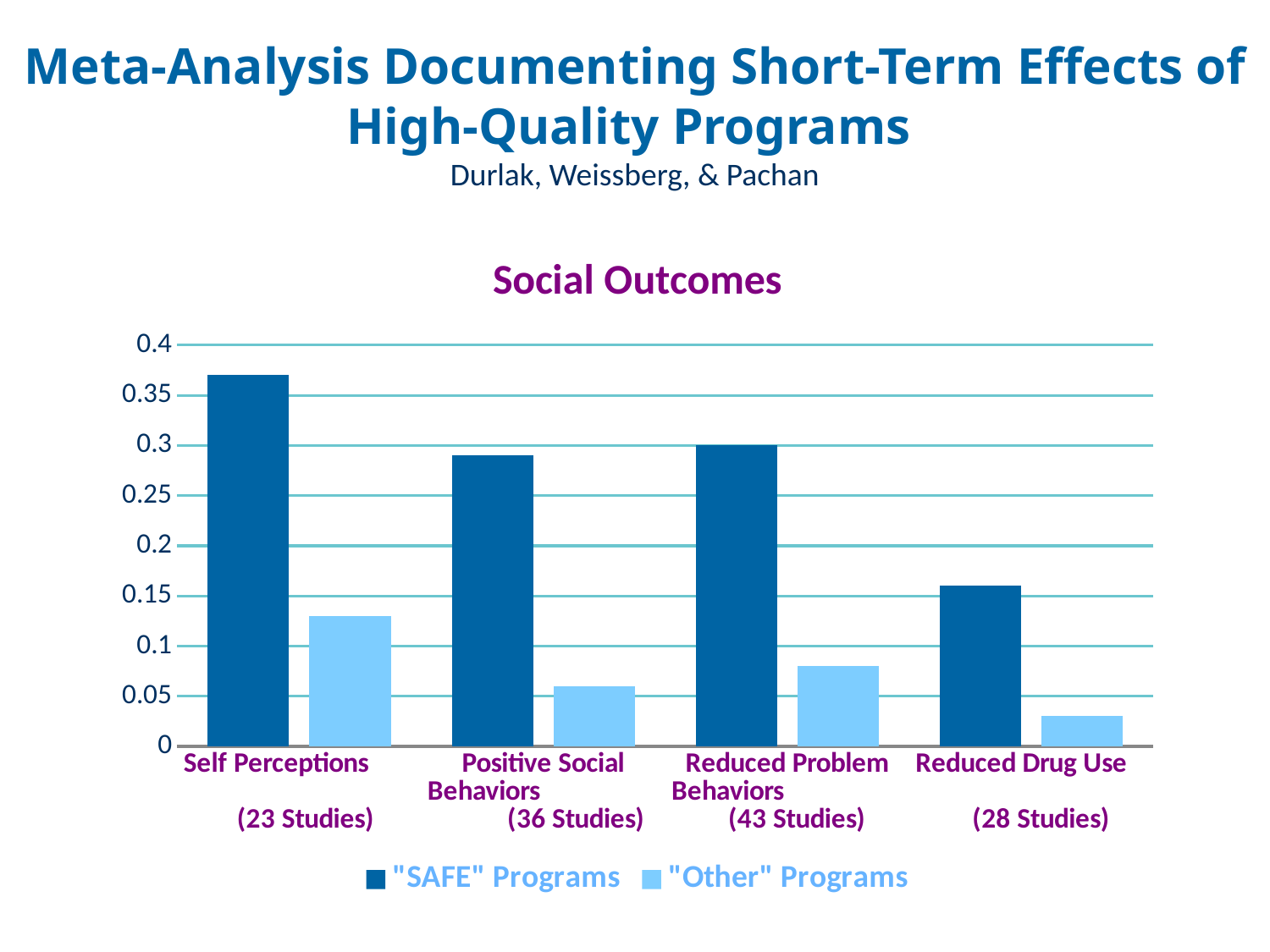
Is the "SAFE" Programs value for Self Perceptions greater or less than 0.35? greater Which category has the highest value for "Other" Programs? Self Perceptions How many series does the legend list? 2 Is the "SAFE" Programs value for Reduced Drug Use greater or less than 0.2? less Which category has the lowest value for "Other" Programs? Reduced Drug Use Is the "Other" Programs value for Self Perceptions greater or less than 0.1? greater How many outcome categories are shown on the x axis? 4 Which category has the lowest value for "SAFE" Programs? Reduced Drug Use For Reduced Problem Behaviors, which series has the larger value, "SAFE" Programs or "Other" Programs? "SAFE" Programs What kind of chart is shown under the title "Social Outcomes"? bar chart Which category has the highest value for "SAFE" Programs? Self Perceptions